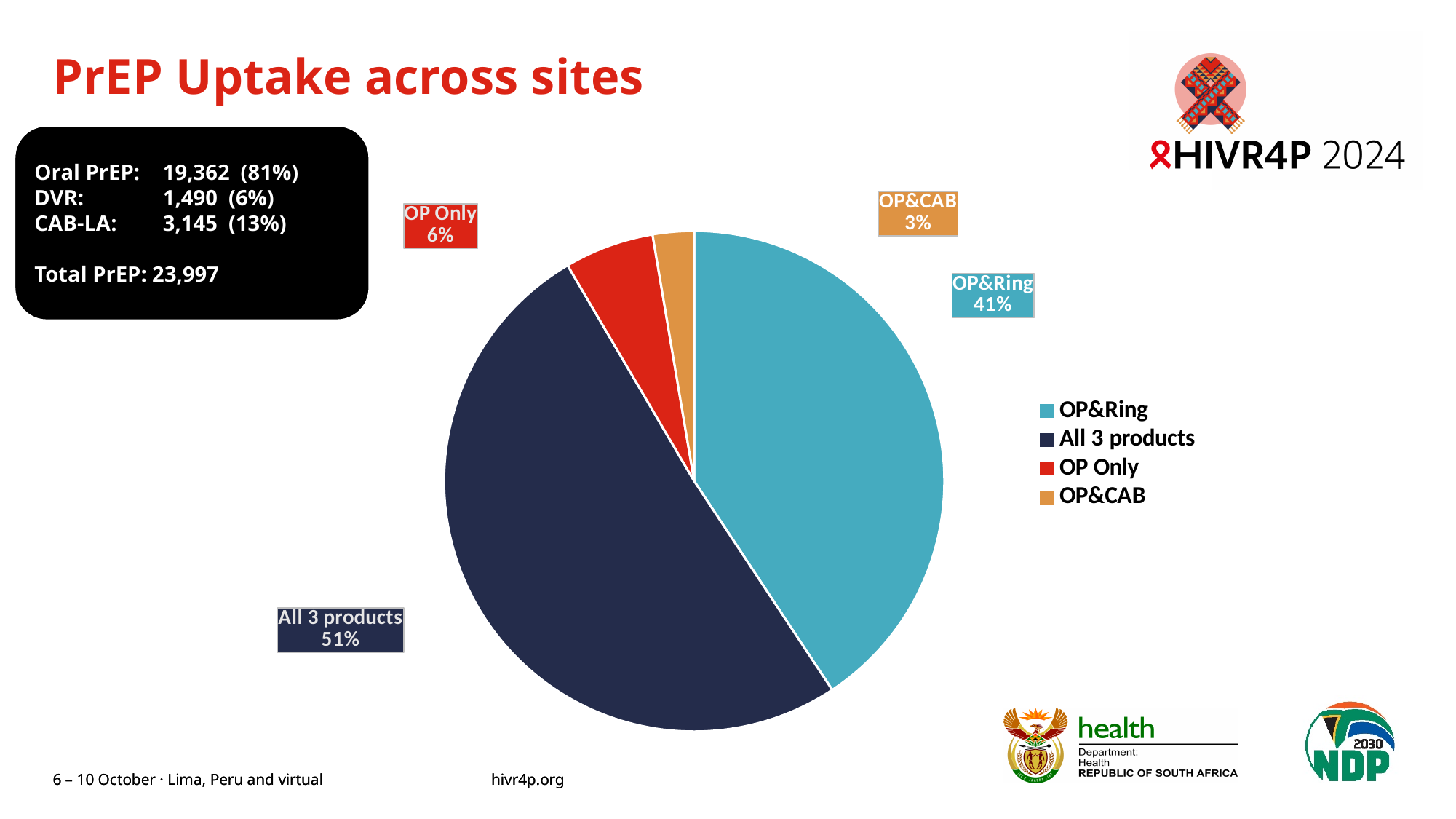
What share of the pie does the OP Only slice represent? 6% What share of the pie does the OP&Ring slice represent? 41% Which slice of the pie is the smallest? OP&CAB How many entries does the legend list? 4 What is the difference in percentage points between the All 3 products slice and the OP&Ring slice? 10 percentage points What share of the pie does the OP&CAB slice represent? 3% What kind of chart is shown on the slide? pie chart What colour is the OP Only slice in the pie chart? red How many slices does the pie chart have? 4 Which slice is larger, OP Only or OP&CAB? OP Only Which slice of the pie is the largest? All 3 products